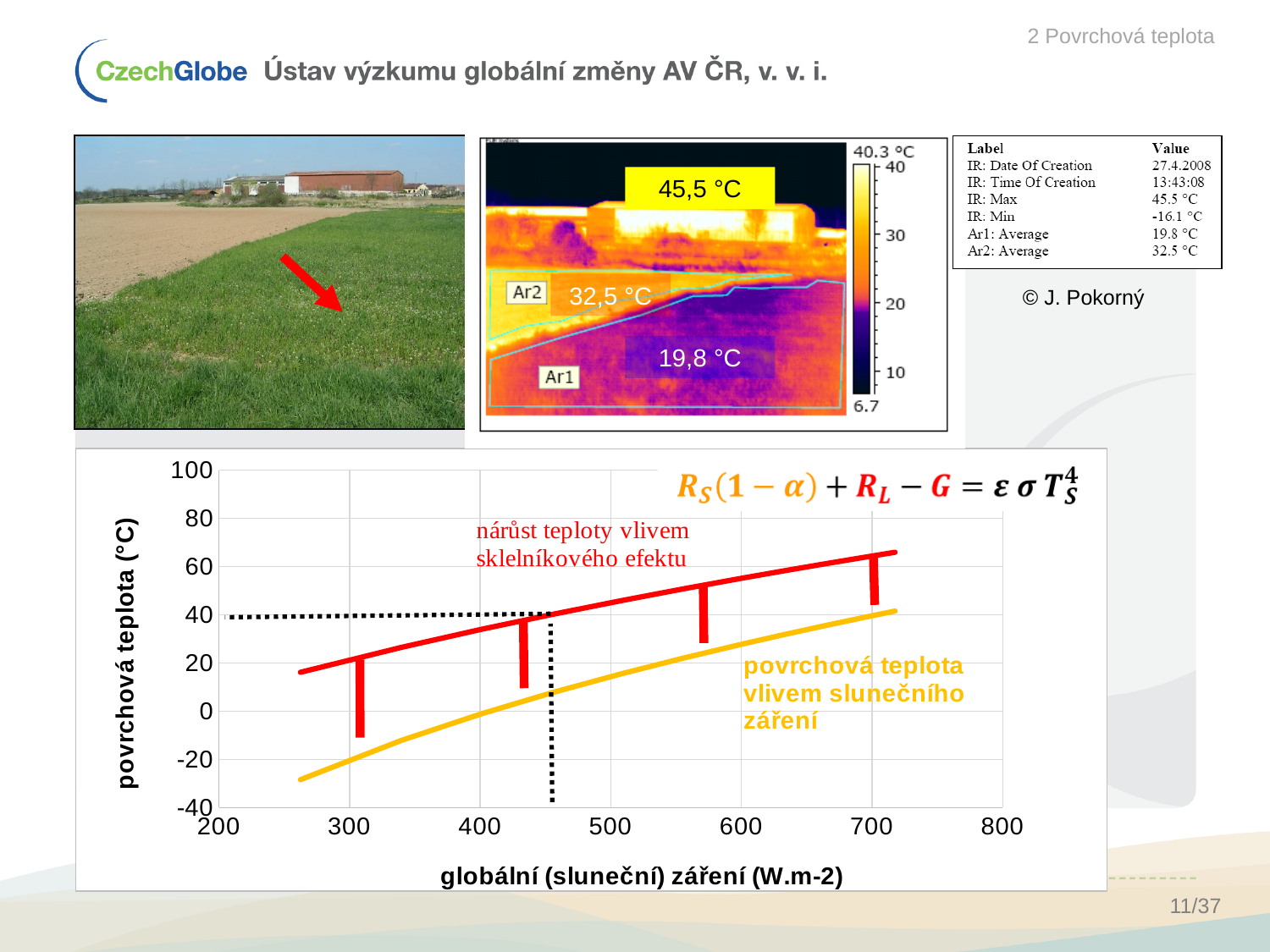
Is the value of the yellow curve at 600 W.m-2 greater or less than 40 °C? less Do the plotted curves rise or fall as globální (sluneční) záření increases? rise Which curve lies higher across the chart, the red curve (nárůst teploty vlivem skleníkového efektu) or the yellow curve (povrchová teplota vlivem slunečního záření)? the red curve Is the value of the red curve at 500 W.m-2 greater or less than 20 °C? greater Is the value of the red curve at 300 W.m-2 greater or less than 0 °C? greater What is the highest value shown on the y axis of the chart? 100 What is the label of the y axis of the chart? povrchová teplota (°C) How many curves are plotted in the chart of povrchová teplota against globální (sluneční) záření? 2 What kind of chart is shown at the bottom of the slide? line chart What is the label of the x axis of the chart? globální (sluneční) záření (W.m-2)